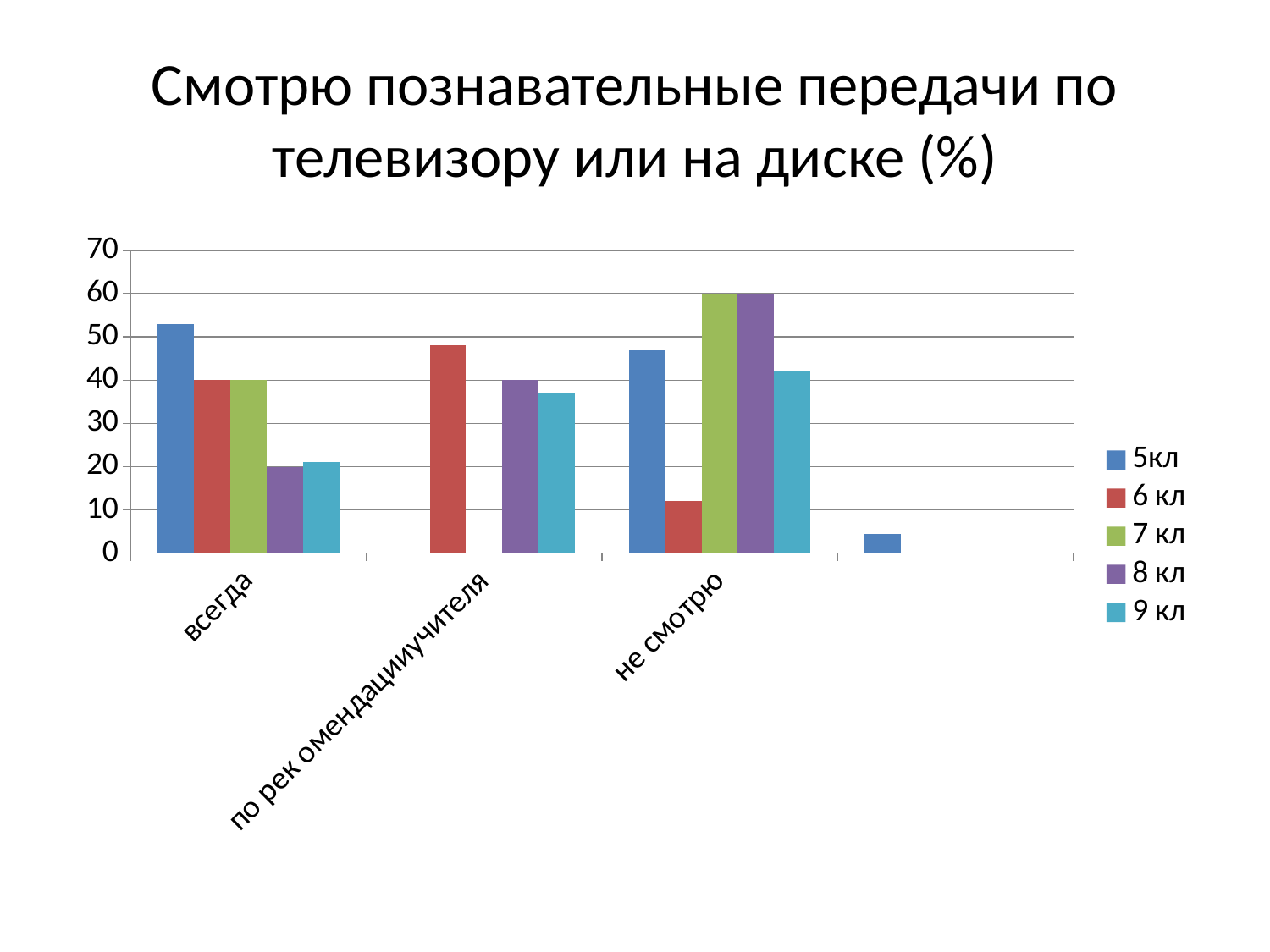
Which series has the highest value in the category "всегда"? 5кл Which series has the lowest value in the category "не смотрю"? 6 кл What is the value for 6 кл in the category "всегда"? 40 In the category "не смотрю", which is larger: the value for 5кл or the value for 9 кл? 5кл What is the value for 8 кл in the category "всегда"? 20 What is the value for 7 кл in the category "не смотрю"? 60 What kind of chart is shown on the slide? bar chart Is the value for 5кл in the category "всегда" greater or less than 50? greater What is the title of the chart? Смотрю познавательные передачи по телевизору или на диске (%) How many series does the legend list? 5 Is the value for 9 кл in the category "по рекомендации учителя" greater or less than 40? less What is the value for 8 кл in the category "по рекомендации учителя"? 40